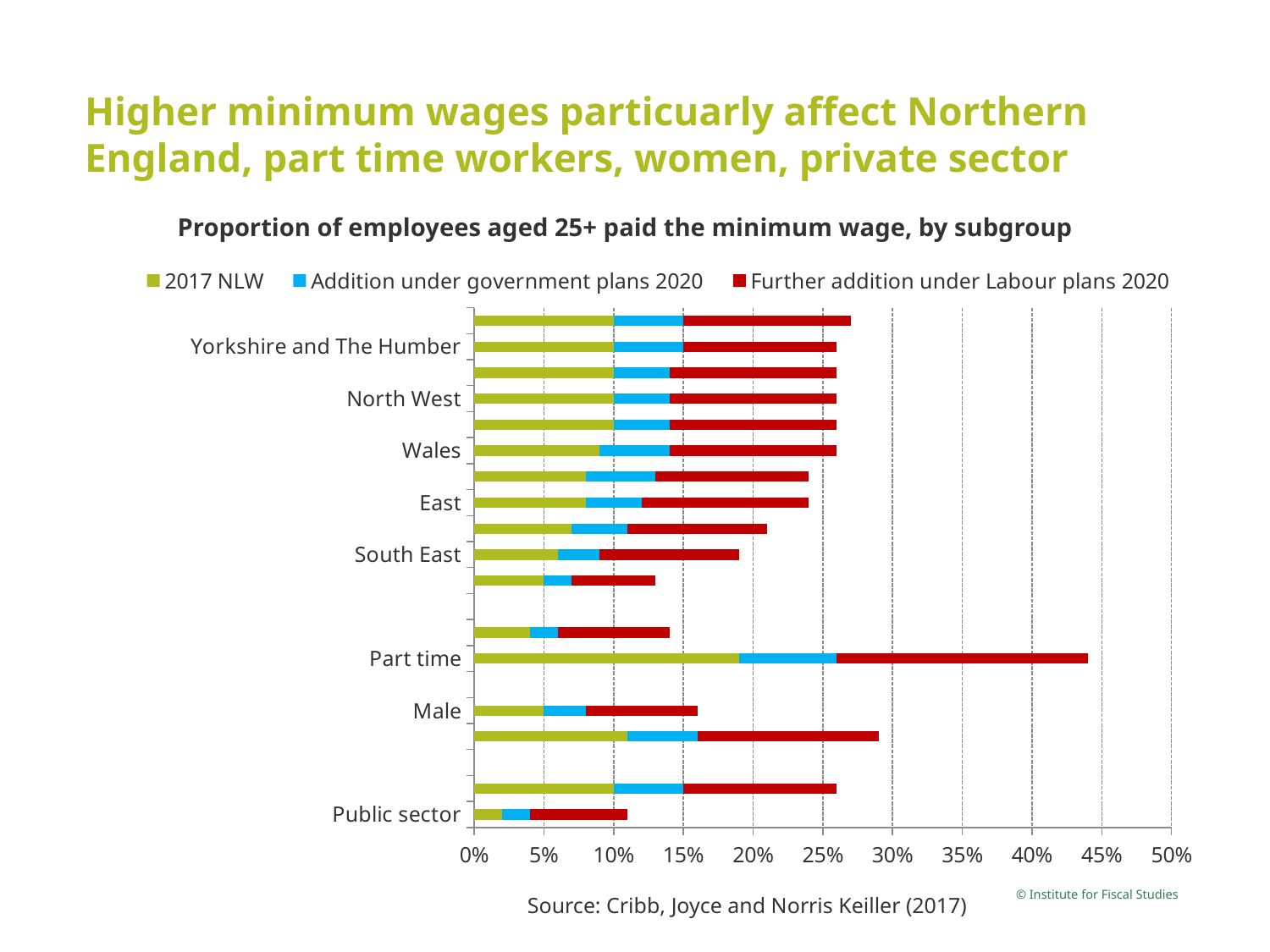
Is the total bar for Male greater or less than 20%? less Which has the longer total bar, Yorkshire and The Humber or South East? Yorkshire and The Humber Is the total bar for Yorkshire and The Humber greater or less than 30%? less What kind of chart is shown on the slide? Stacked bar chart What is the title of the chart? Proportion of employees aged 25+ paid the minimum wage, by subgroup Is the total bar for Part time greater or less than 40%? greater How many series does the legend list? 3 Which labelled subgroup has the shortest total bar? Public sector Which labelled subgroup has the longest total bar? Part time Which series is shown in red in the legend? Further addition under Labour plans 2020